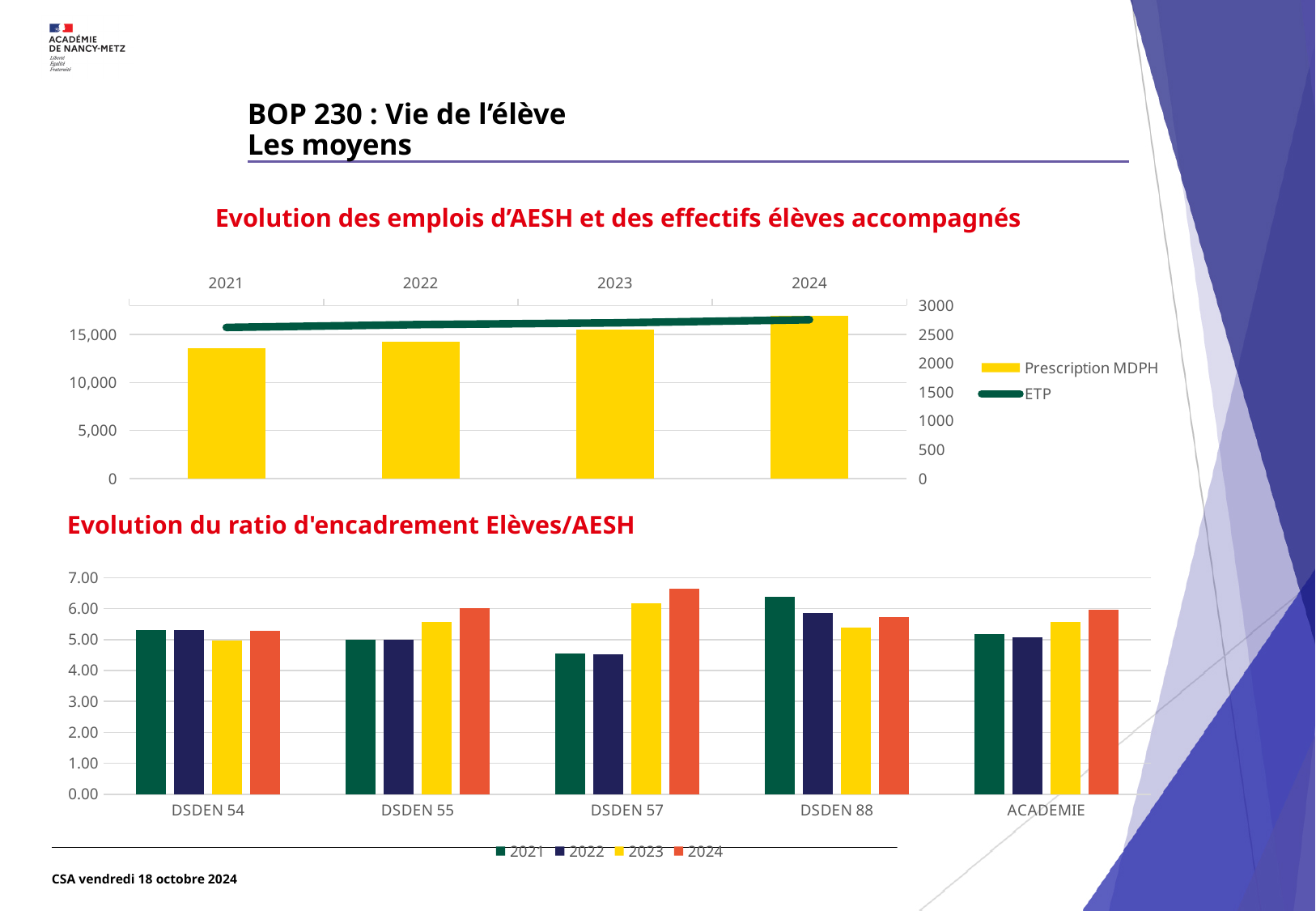
In the bottom chart "Evolution du ratio d'encadrement Elèves/AESH", how many series does the legend list? 4 In the bottom chart "Evolution du ratio d'encadrement Elèves/AESH", how many categories are shown on the x axis? 5 What kind of chart is the bottom chart titled "Evolution du ratio d'encadrement Elèves/AESH"? bar chart In the bottom chart "Evolution du ratio d'encadrement Elèves/AESH", which is larger for 2021: DSDEN 88 or DSDEN 54? DSDEN 88 In the bottom chart "Evolution du ratio d'encadrement Elèves/AESH", which category has the highest 2024 value? DSDEN 57 In the top chart "Evolution des emplois d'AESH et des effectifs élèves accompagnés", what is the name of the series drawn as a line? ETP In the top chart "Evolution des emplois d'AESH et des effectifs élèves accompagnés", which year has the highest Prescription MDPH bar? 2024 In the top chart "Evolution des emplois d'AESH et des effectifs élèves accompagnés", how many series does the legend list? 2 In the top chart "Evolution des emplois d'AESH et des effectifs élèves accompagnés", do the Prescription MDPH bars rise or fall from 2021 to 2024? rise In the top chart "Evolution des emplois d'AESH et des effectifs élèves accompagnés", is the Prescription MDPH value for 2021 greater or less than 15,000? less In the top chart "Evolution des emplois d'AESH et des effectifs élèves accompagnés", which year has the lowest Prescription MDPH bar? 2021 In the bottom chart "Evolution du ratio d'encadrement Elèves/AESH", is the 2021 value for DSDEN 57 greater or less than 5.00? less